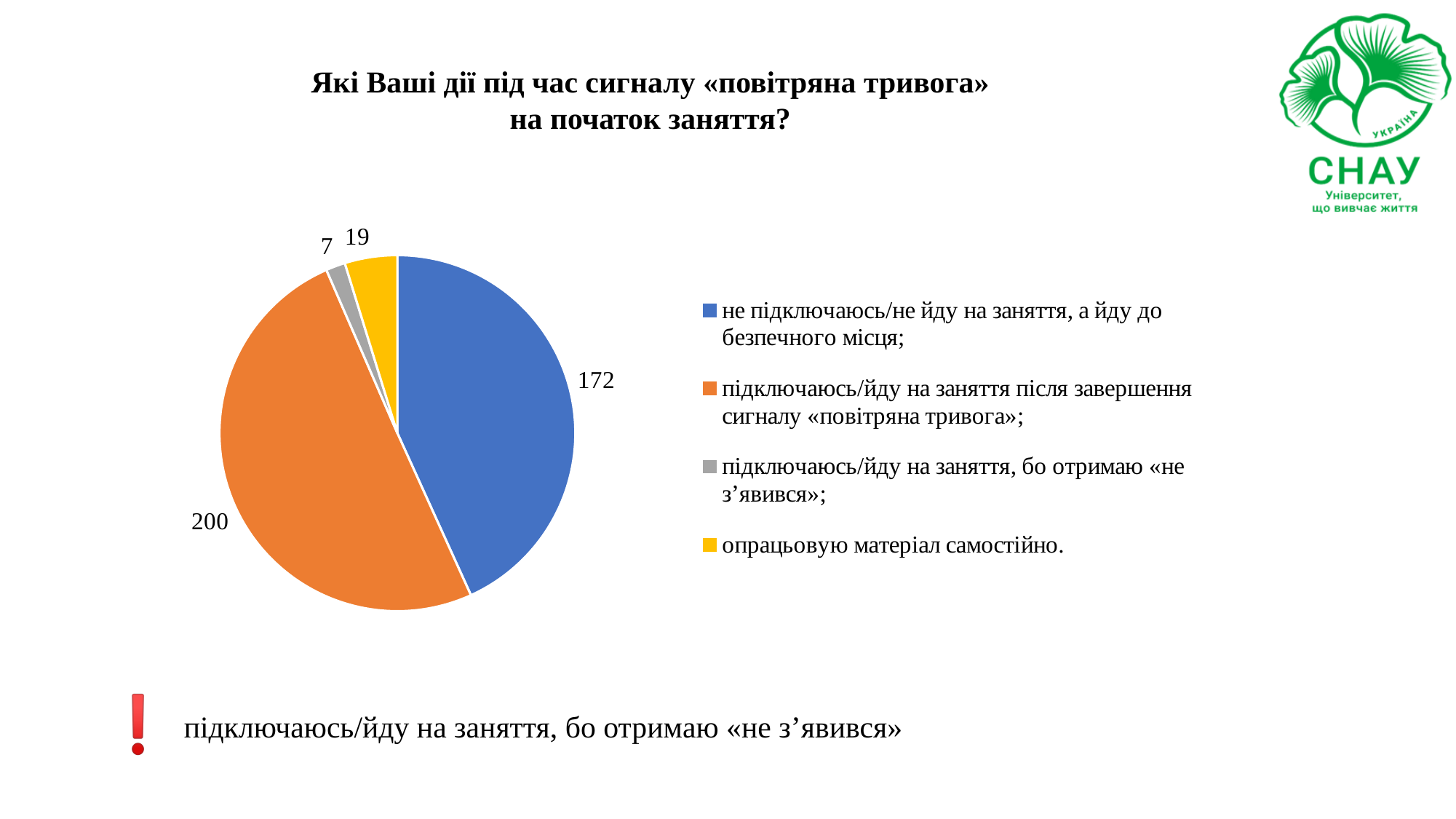
Which is larger: the value for «опрацьовую матеріал самостійно» or the value for «підключаюсь/йду на заняття, бо отримаю «не з’явився»»? опрацьовую матеріал самостійно What is the value for «підключаюсь/йду на заняття після завершення сигналу «повітряна тривога»»? 200 What is the value for «не підключаюсь/не йду на заняття, а йду до безпечного місця»? 172 What colour is the slice for «опрацьовую матеріал самостійно»? yellow What is the value for «підключаюсь/йду на заняття, бо отримаю «не з’явився»»? 7 What kind of chart is shown on the slide? pie chart Which category has the smallest slice? підключаюсь/йду на заняття, бо отримаю «не з’явився» How many entries does the legend list? 4 How many slices does the pie chart have? 4 Which category has the largest slice? підключаюсь/йду на заняття після завершення сигналу «повітряна тривога» What is the value for «опрацьовую матеріал самостійно»? 19 What is the difference between the values for «підключаюсь/йду на заняття після завершення сигналу «повітряна тривога»» and «не підключаюсь/не йду на заняття, а йду до безпечного місця»? 28